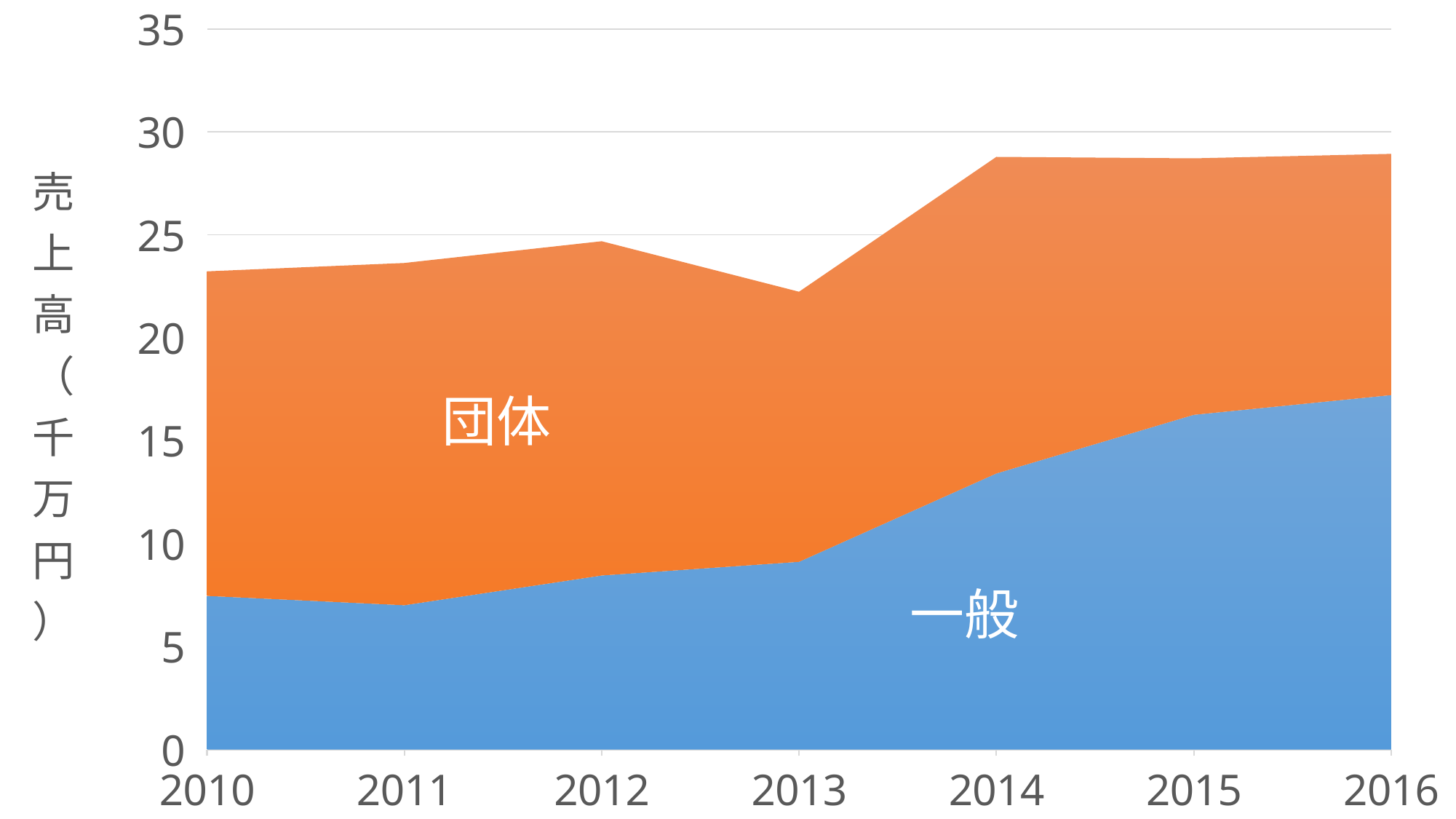
Is the value for 一般 in 2011 greater or less than 10? less In which year is the stacked total (一般 plus 団体) lowest? 2013 Is the value for 一般 in 2014 greater or less than 10? greater How many series does the chart show? 2 Is the value for 一般 in 2016 greater or less than 15? greater What kind of chart is shown on the slide? Stacked area chart Does the value for 一般 generally rise or fall from 2010 to 2016? rise Which colour represents the 一般 series? Blue How many years are plotted along the x axis? 7 What is the label of the vertical axis? 売上高（千万円）